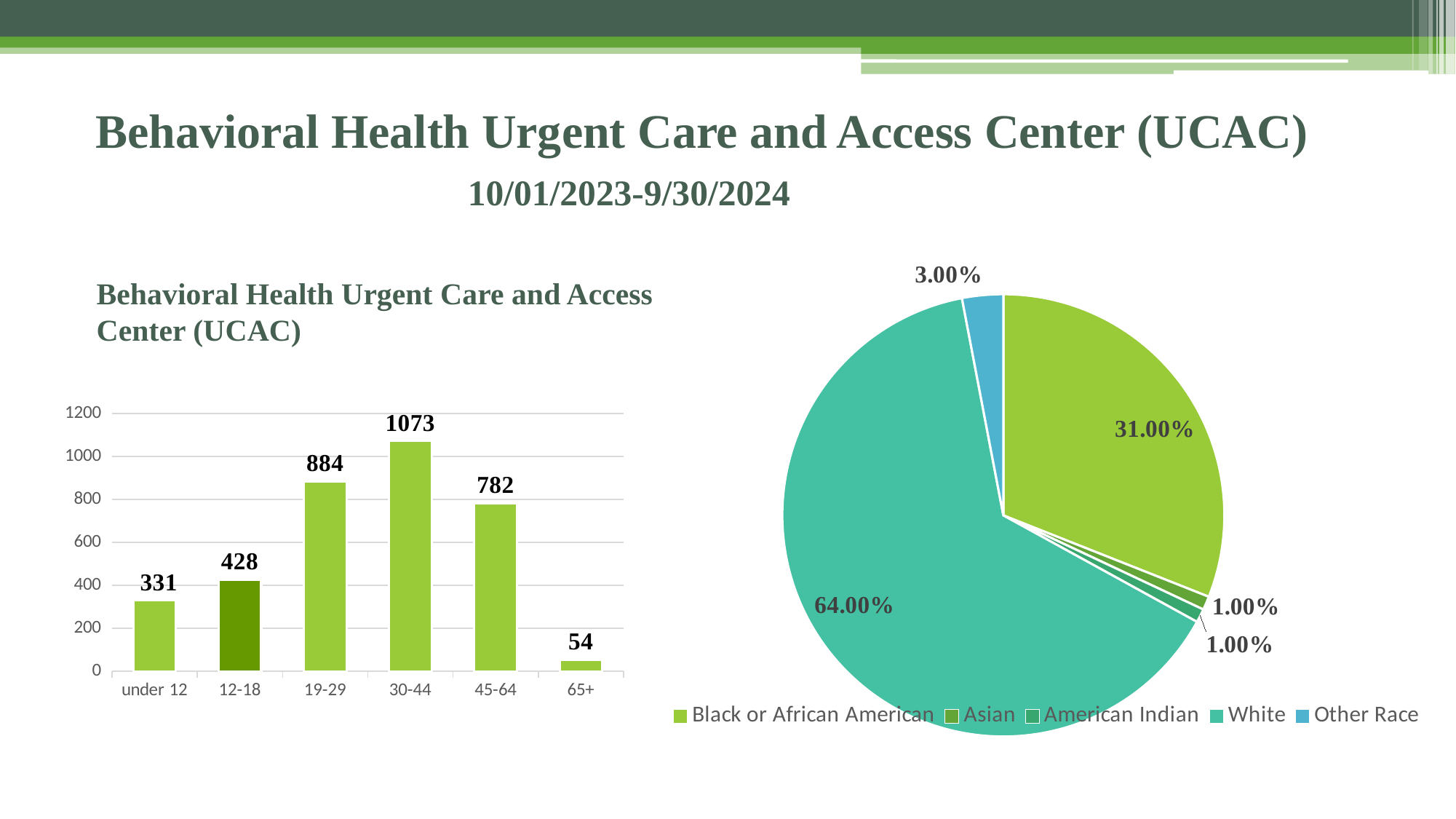
In the bar chart on the left, what is the value for the 30-44 age group? 1073 How many categories does the legend of the pie chart on the right list? 5 In the bar chart on the left, what is the value for the under 12 age group? 331 In the pie chart on the right, what share does Other Race have? 3.00% In the bar chart on the left, which age group has the lowest value? 65+ In the bar chart on the left, which age group has the highest value? 30-44 In the pie chart on the right, what share does White have? 64.00% How many age groups are shown in the bar chart on the left? 6 In the bar chart on the left, which is larger, the value for 12-18 or the value for under 12? 12-18 In the bar chart on the left, what is the difference between the values for 19-29 and 45-64? 102 In the pie chart on the right, what share does Black or African American have? 31.00% What kind of chart is the chart on the left of the slide? bar chart